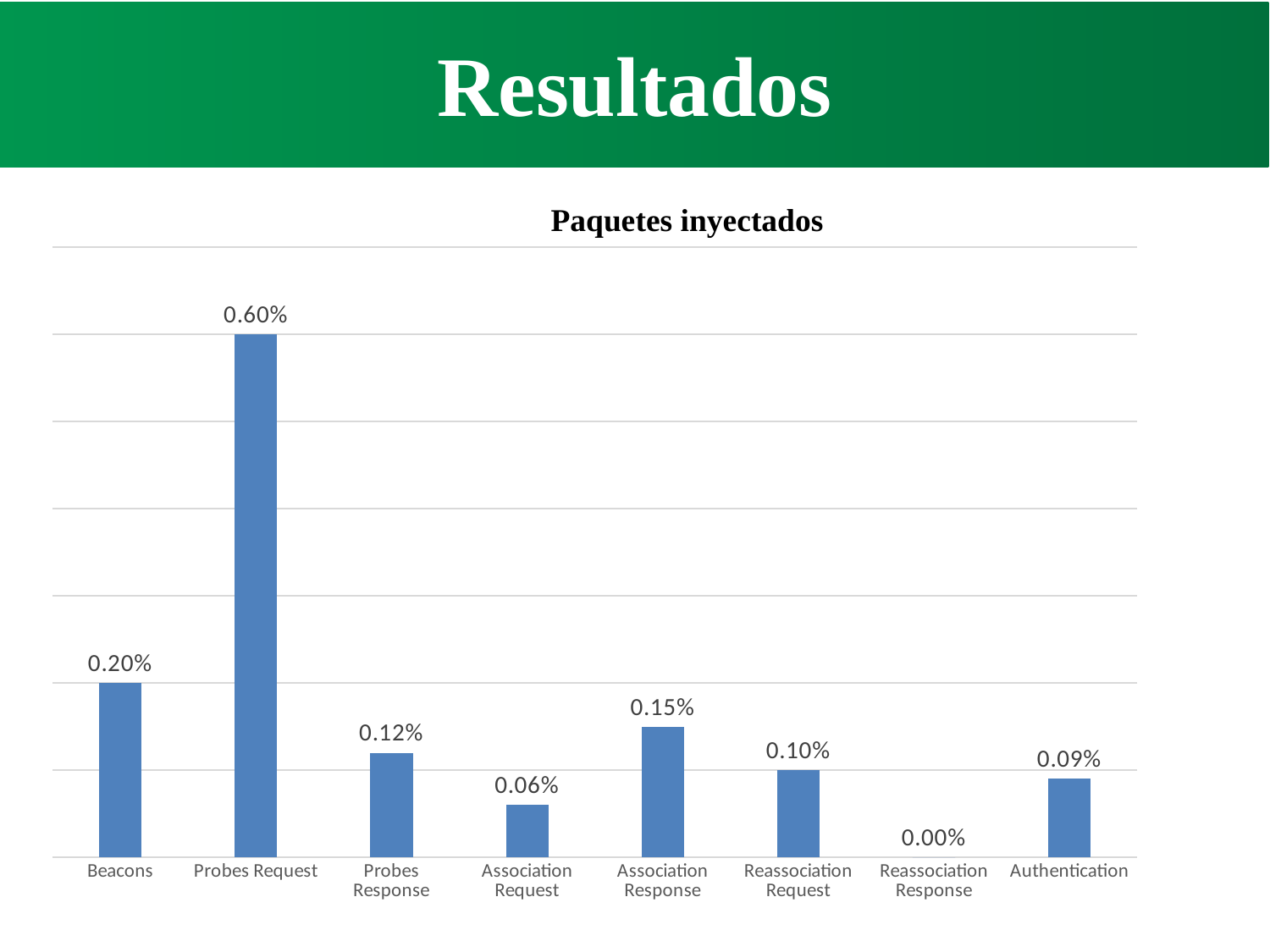
What is the value for Reassociation Response? 0.00% What is the difference between the values for Probes Request and Beacons? 0.40% What is the title of the chart? Paquetes inyectados Which category has the lowest value? Reassociation Response What kind of chart is shown on the slide? Bar chart What is the value for Probes Request? 0.60% Which is larger, the value for Probes Response or the value for Authentication? Probes Response What is the value for Association Request? 0.06% Which category has the highest value? Probes Request What is the difference between the values for Association Response and Reassociation Request? 0.05% What is the value for Beacons? 0.20% How many categories are shown on the x axis? 8